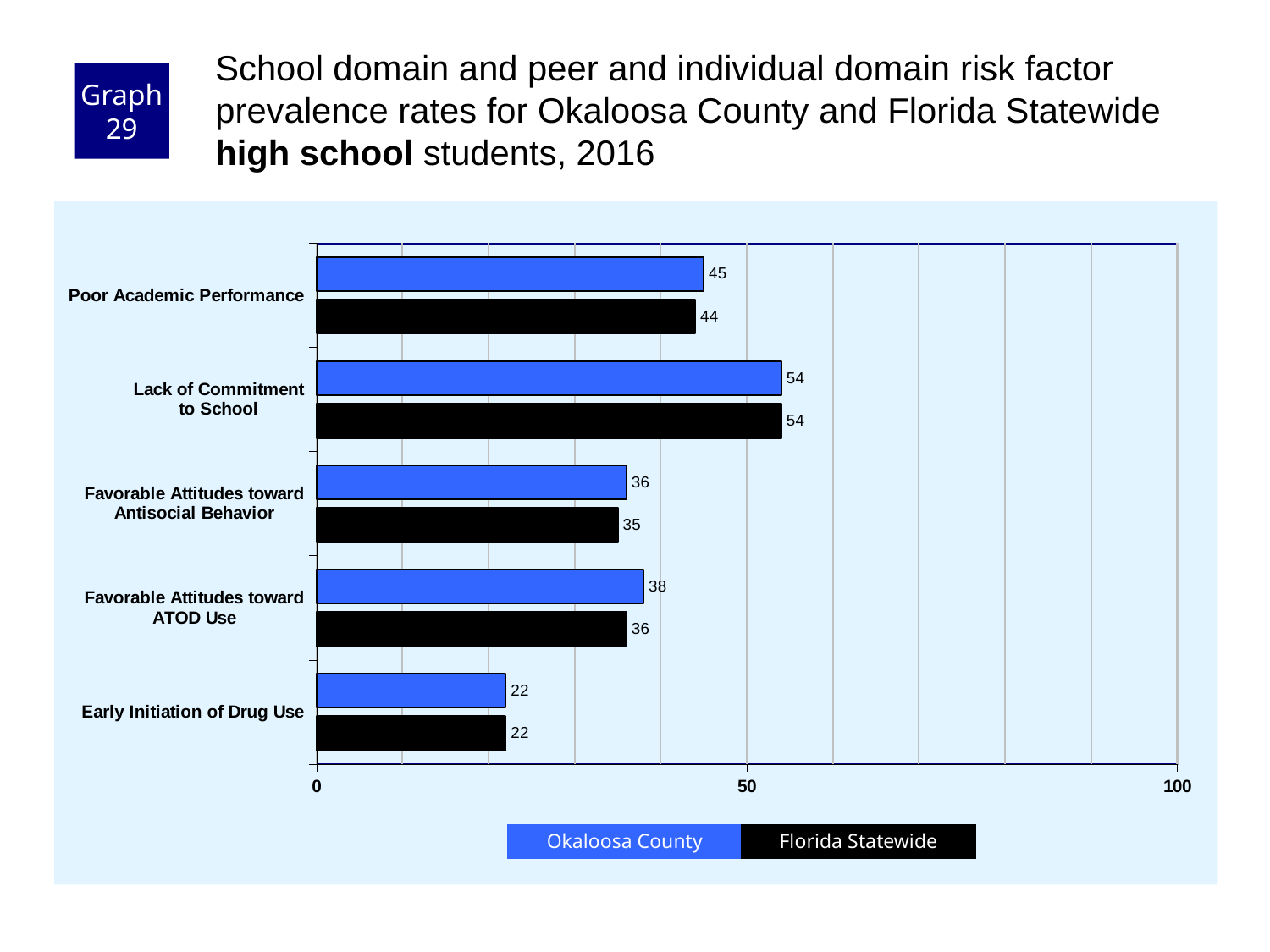
Which colour represents Florida Statewide in the chart? Black How many risk factor categories are shown on the chart? 5 Which is larger for Poor Academic Performance: the Okaloosa County value or the Florida Statewide value? Okaloosa County How many series does the legend list? 2 Which risk factor has the lowest Florida Statewide value? Early Initiation of Drug Use What is the difference between the Okaloosa County and Florida Statewide values for Favorable Attitudes toward ATOD Use? 2 What is the Okaloosa County value for Poor Academic Performance? 45 Which risk factor has the highest Okaloosa County value? Lack of Commitment to School What kind of chart is shown on the slide? Bar chart What is the Florida Statewide value for Favorable Attitudes toward ATOD Use? 36 Is the Okaloosa County value for Lack of Commitment to School greater or less than 50? greater What is the Okaloosa County value for Early Initiation of Drug Use? 22